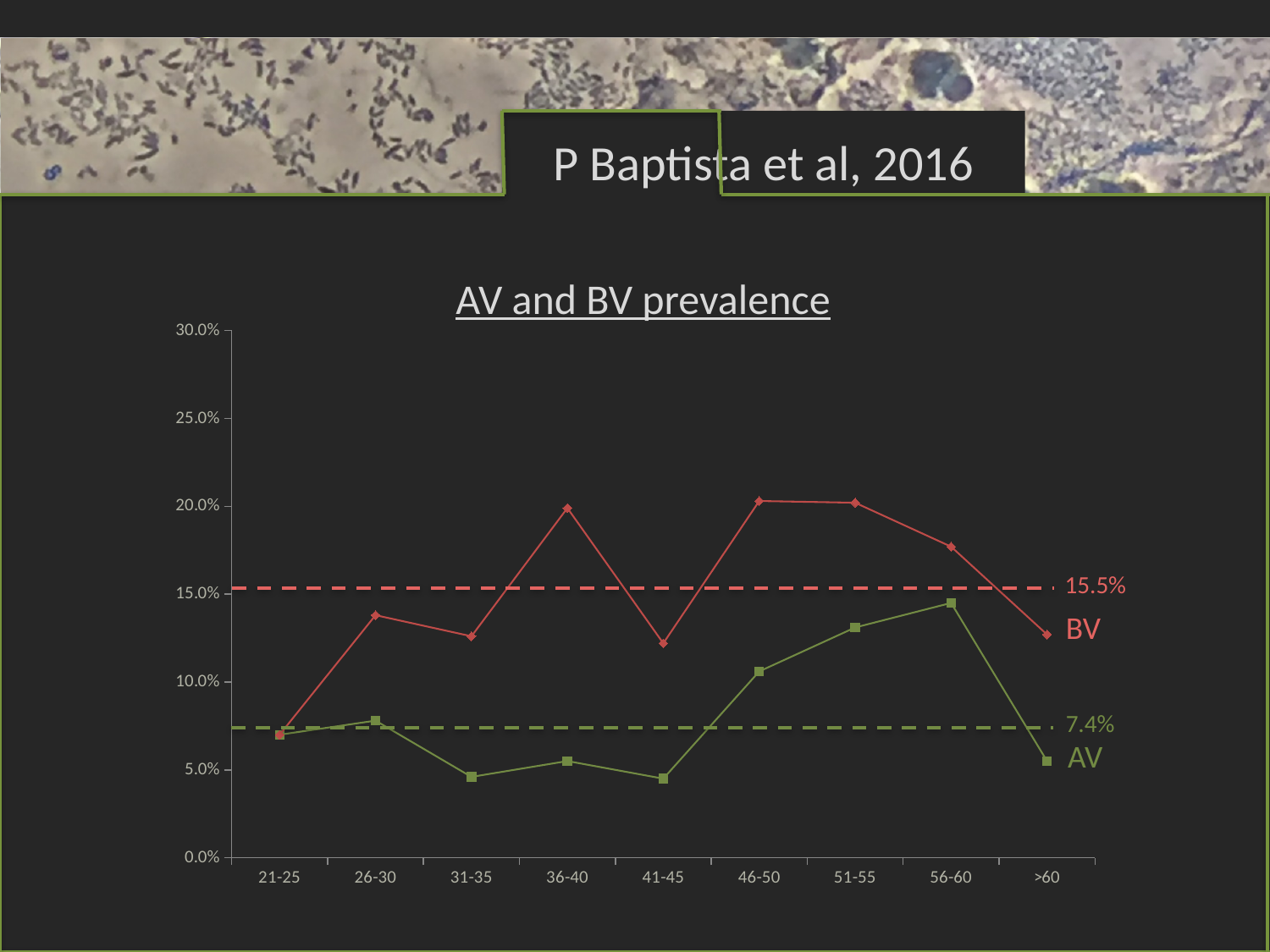
Is the BV value for the 36-40 age group greater or less than 15.0%? greater Is the BV value for the 41-45 age group greater or less than 15.0%? less In which age group does the BV series have its lowest value? 21-25 Is the BV value for the >60 age group greater or less than 15.0%? less How many age groups are shown on the x axis of the chart? 9 What kind of chart is shown on the slide? line chart In which age group does the AV series reach its highest value? 56-60 How many series are plotted in the chart? 2 For the 36-40 age group, which series has the higher value, BV or AV? BV What value is labelled on the red dashed horizontal line? 15.5% What is the title of the chart? AV and BV prevalence